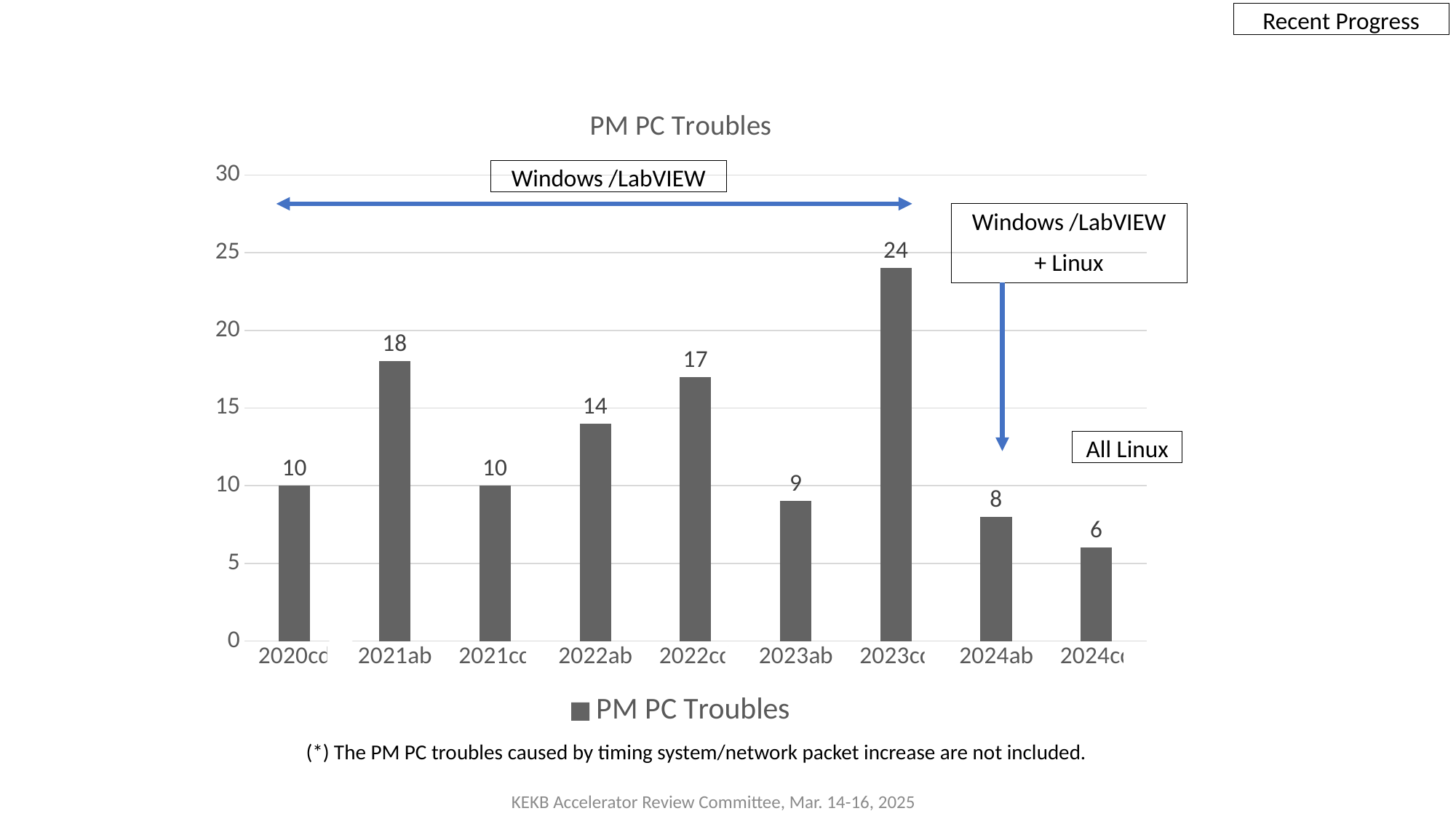
What is the value for 2023ab in the PM PC Troubles chart? 9 Which is larger, the value for 2022ab or the value for 2022cc? 2022cc What is the value for 2021ab in the PM PC Troubles chart? 18 What is the title of the chart? PM PC Troubles Is the value for 2021ab greater or less than 15? greater Which category has the highest value in the PM PC Troubles chart? 2023cc Which category has the lowest value in the PM PC Troubles chart? 2024cc What is the difference between the values for 2023cc and 2024ab? 16 What kind of chart is shown on the slide? bar chart What is the value for 2024cc in the PM PC Troubles chart? 6 How many categories are shown on the x axis of the chart? 9 How many series does the legend list? 1